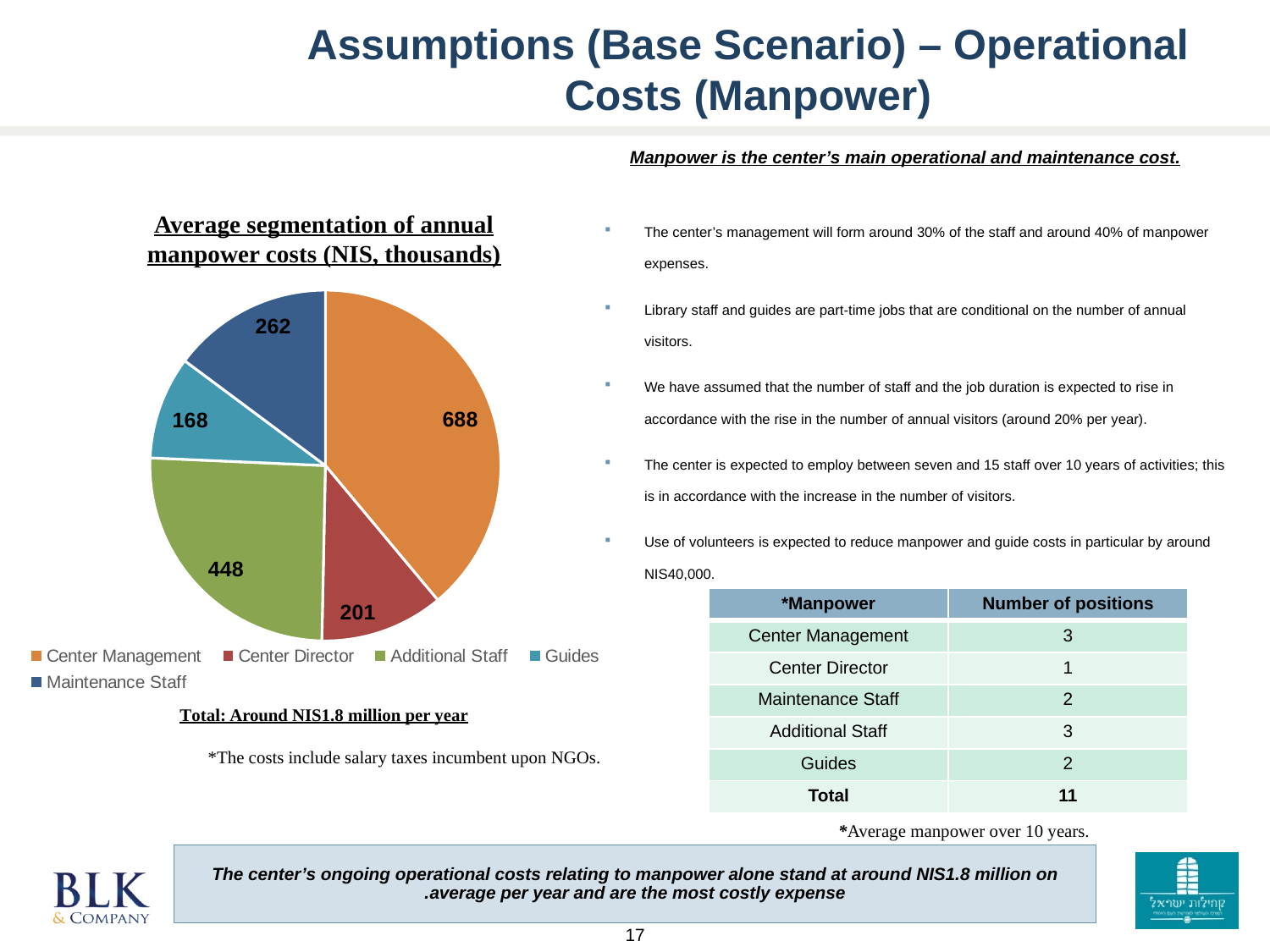
How many categories does the pie chart show? 5 Which is larger, the value for Maintenance Staff or the value for Center Director? Maintenance Staff What is the value for Maintenance Staff in the pie chart? 262 What is the value for Center Director in the pie chart? 201 What is the value for Guides in the pie chart? 168 Which category has the smallest slice in the pie chart? Guides What is the value for Additional Staff in the pie chart? 448 What is the title of the pie chart? Average segmentation of annual manpower costs (NIS, thousands) What is the value for Center Management in the pie chart? 688 What is the difference between the values for Center Management and Additional Staff? 240 What type of chart is shown on the slide? pie chart Which category has the largest slice in the pie chart? Center Management